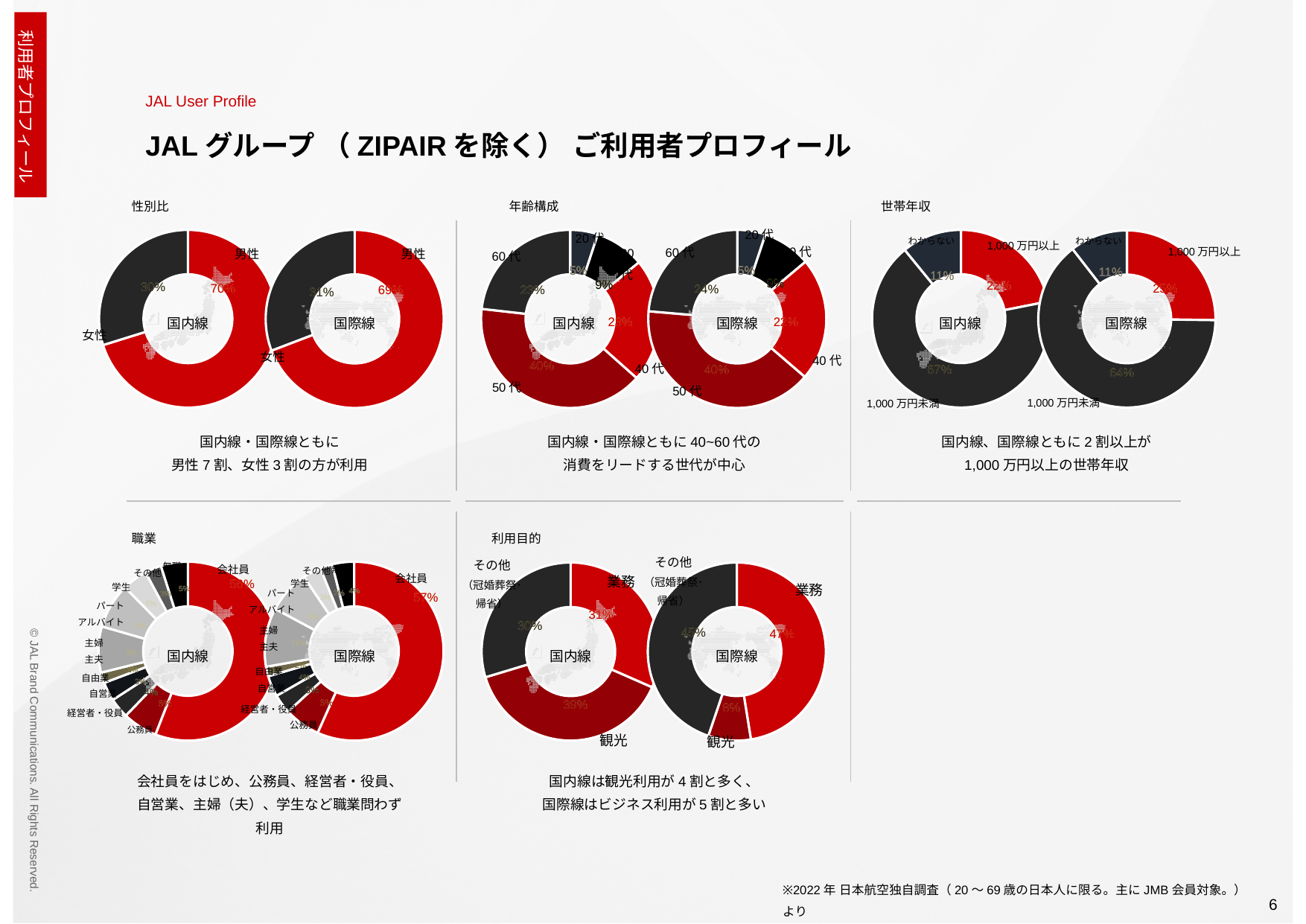
In the 世帯年収 chart for 国際線, what percentage is 1,000万円以上? 25% In the 性別比 chart for 国際線, what percentage is 女性? 31% In the 年齢構成 chart for 国内線, what percentage is 50代? 40% In the 年齢構成 chart for 国際線, which age group has the largest share? 50代 In the 職業 chart for 国際線, what percentage is 会社員? 57% In the 世帯年収 chart for 国内線, what percentage is 1,000万円未満? 67% What kind of chart is used throughout this slide? Donut (pie) chart In the 世帯年収 charts, what is the difference between the 1,000万円未満 share for 国内線 and for 国際線? 3% In the 利用目的 chart for 国際線, what percentage is 業務? 47% In the 年齢構成 chart for 国内線, which age group has the smallest share? 20代 In the 性別比 chart for 国内線, what percentage is 男性? 70% In the 利用目的 chart for 国内線, which purpose has the largest share? 観光